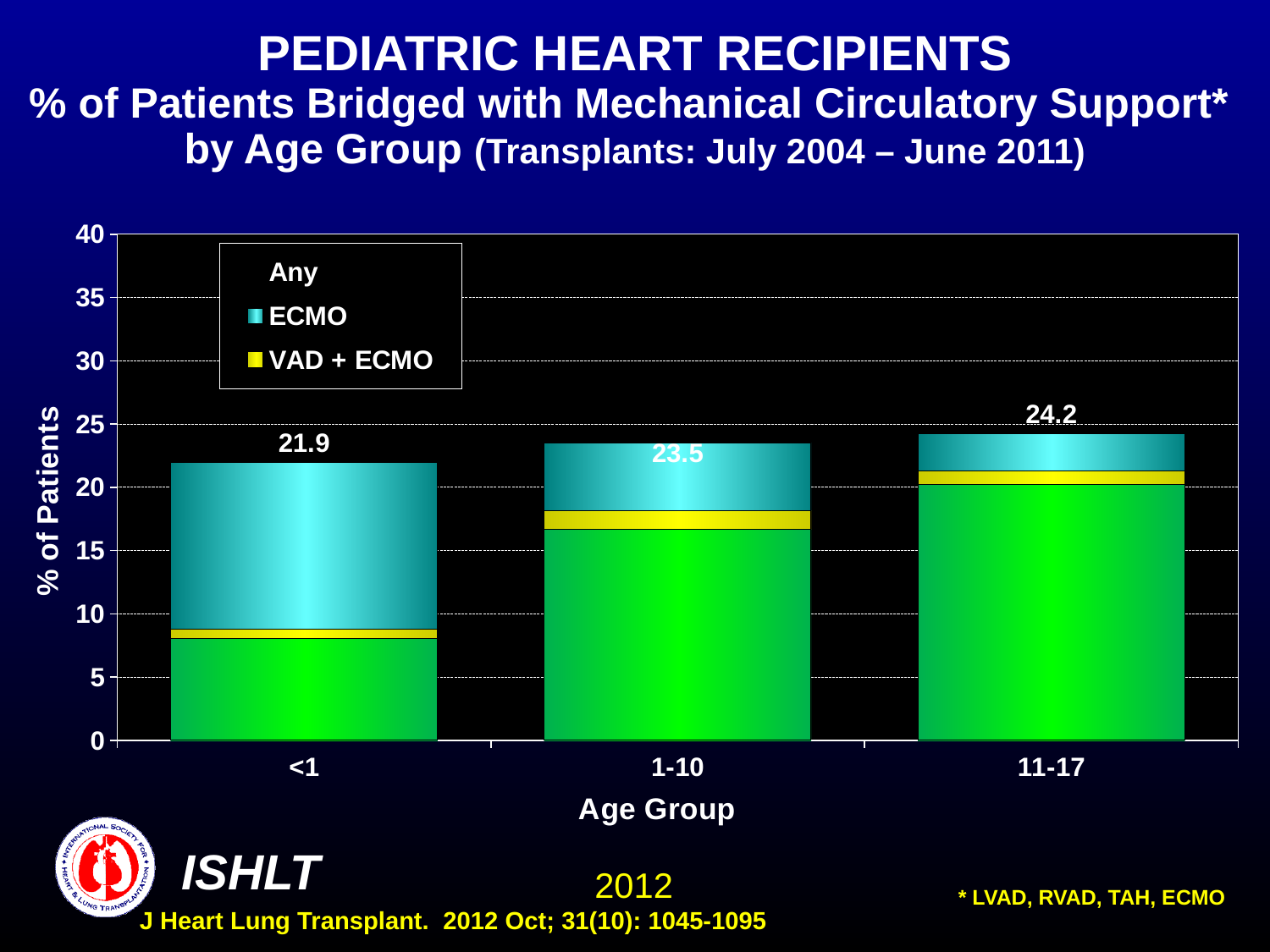
Which age group has the lowest total percentage of patients bridged with mechanical circulatory support? <1 What is the total percentage of patients bridged with mechanical circulatory support in the 1-10 age group? 23.5 Do the total percentages rise or fall as the age group increases from <1 to 11-17? Rise What kind of chart is shown on the slide? Stacked bar chart How many age groups are shown on the x axis? 3 Which age group has a larger total percentage, 1-10 or 11-17? 11-17 How many entries does the legend list? 3 What is the difference between the total percentages for the 11-17 and <1 age groups? 2.3 What is the difference between the total percentages for the 1-10 and <1 age groups? 1.6 What is the total percentage of patients bridged with mechanical circulatory support in the <1 age group? 21.9 Which age group has the highest total percentage of patients bridged with mechanical circulatory support? 11-17 What is the total percentage of patients bridged with mechanical circulatory support in the 11-17 age group? 24.2